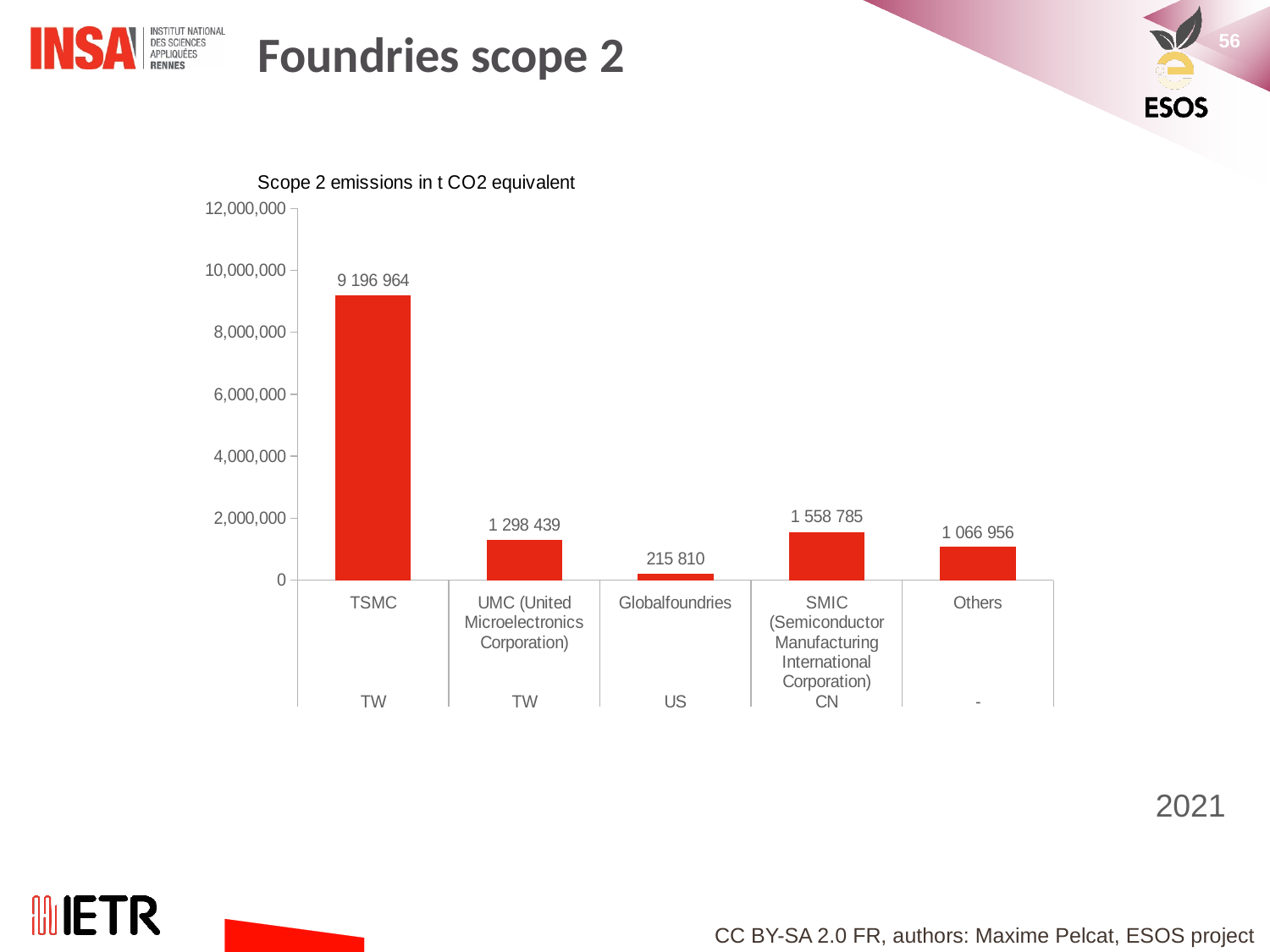
Which foundry has the highest Scope 2 emissions? TSMC Is the Scope 2 emissions value for TSMC greater or less than 8,000,000? greater What is the Scope 2 emissions value for Others? 1 066 956 What is the difference in Scope 2 emissions between TSMC and SMIC? 7 638 179 What is the difference in Scope 2 emissions between SMIC and UMC? 260 346 What is the Scope 2 emissions value for Globalfoundries? 215 810 How many foundry categories are shown in the chart? 5 What is the Scope 2 emissions value for SMIC? 1 558 785 Which foundry has the lowest Scope 2 emissions? Globalfoundries What type of chart is shown on the slide? Bar chart Which has higher Scope 2 emissions, UMC or Others? UMC What is the Scope 2 emissions value for TSMC? 9 196 964